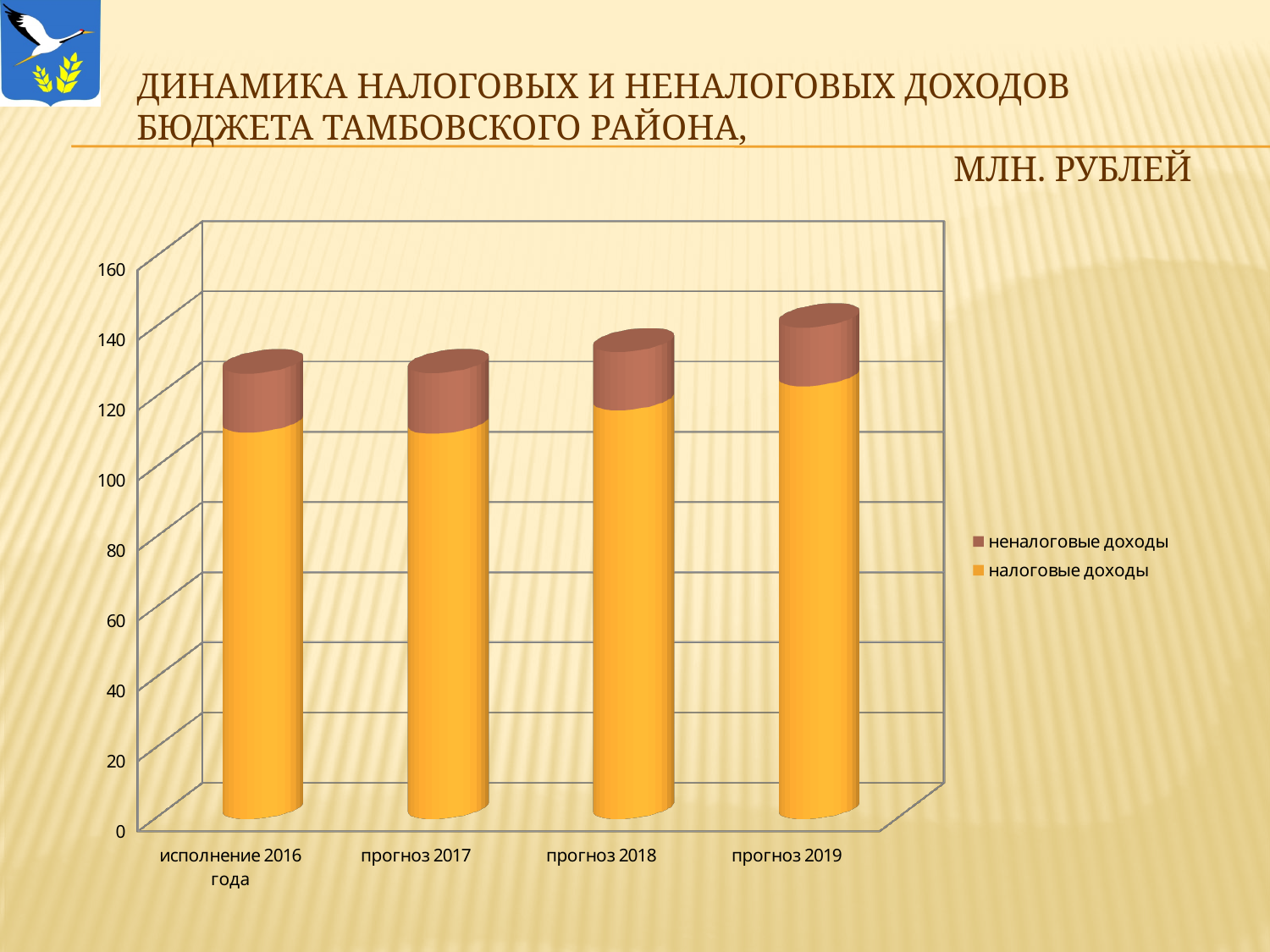
From прогноз 2017 to прогноз 2019, do the total bars rise or fall? rise How many series does the legend list? 2 Is the value of неналоговые доходы for прогноз 2018 greater or less than 40? less What kind of chart is shown on the slide? bar chart Is the value of налоговые доходы for исполнение 2016 года greater or less than 100? greater Which has the larger total bar: прогноз 2017 or прогноз 2018? прогноз 2018 Is the total bar for прогноз 2019 greater or less than 120? greater Which is larger: налоговые доходы for прогноз 2019 or for исполнение 2016 года? прогноз 2019 Which category has the highest total bar? прогноз 2019 Which colour represents неналоговые доходы in the legend? brown How many categories are shown along the x axis? 4 In what units are the values on the chart expressed, according to the slide title? млн. рублей